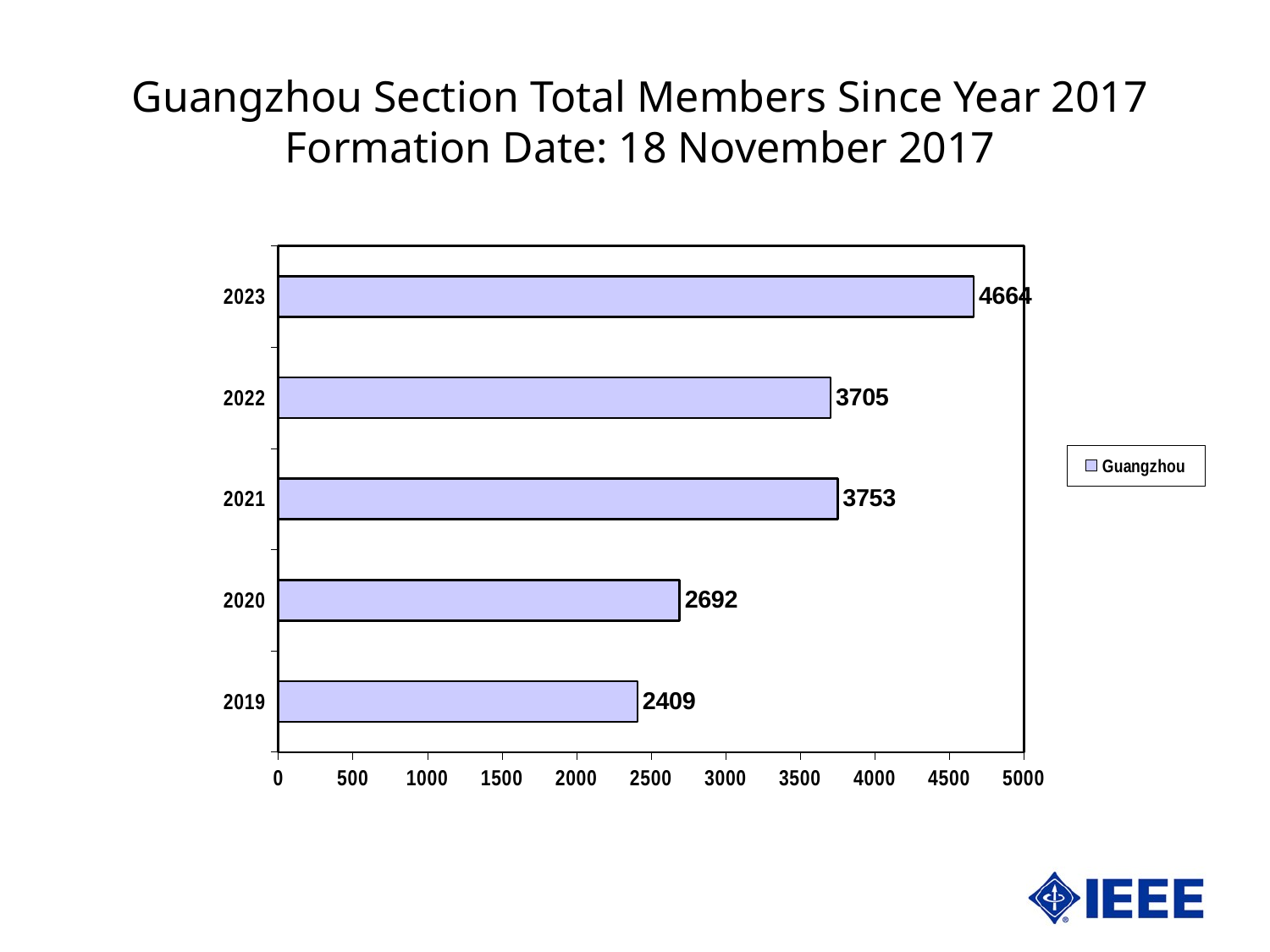
What series name does the legend show? Guangzhou Is the value for 2022 greater or less than 3500? greater Which year has the highest value? 2023 What is the difference between the values for 2020 and 2019? 283 Which is larger, the value for 2021 or the value for 2020? 2021 What kind of chart is shown on the slide? bar chart What is the difference between the values for 2023 and 2022? 959 How many years are shown on the chart? 5 What is the value for 2019? 2409 What is the value for 2023? 4664 What is the value for 2021? 3753 Which year has the lowest value? 2019